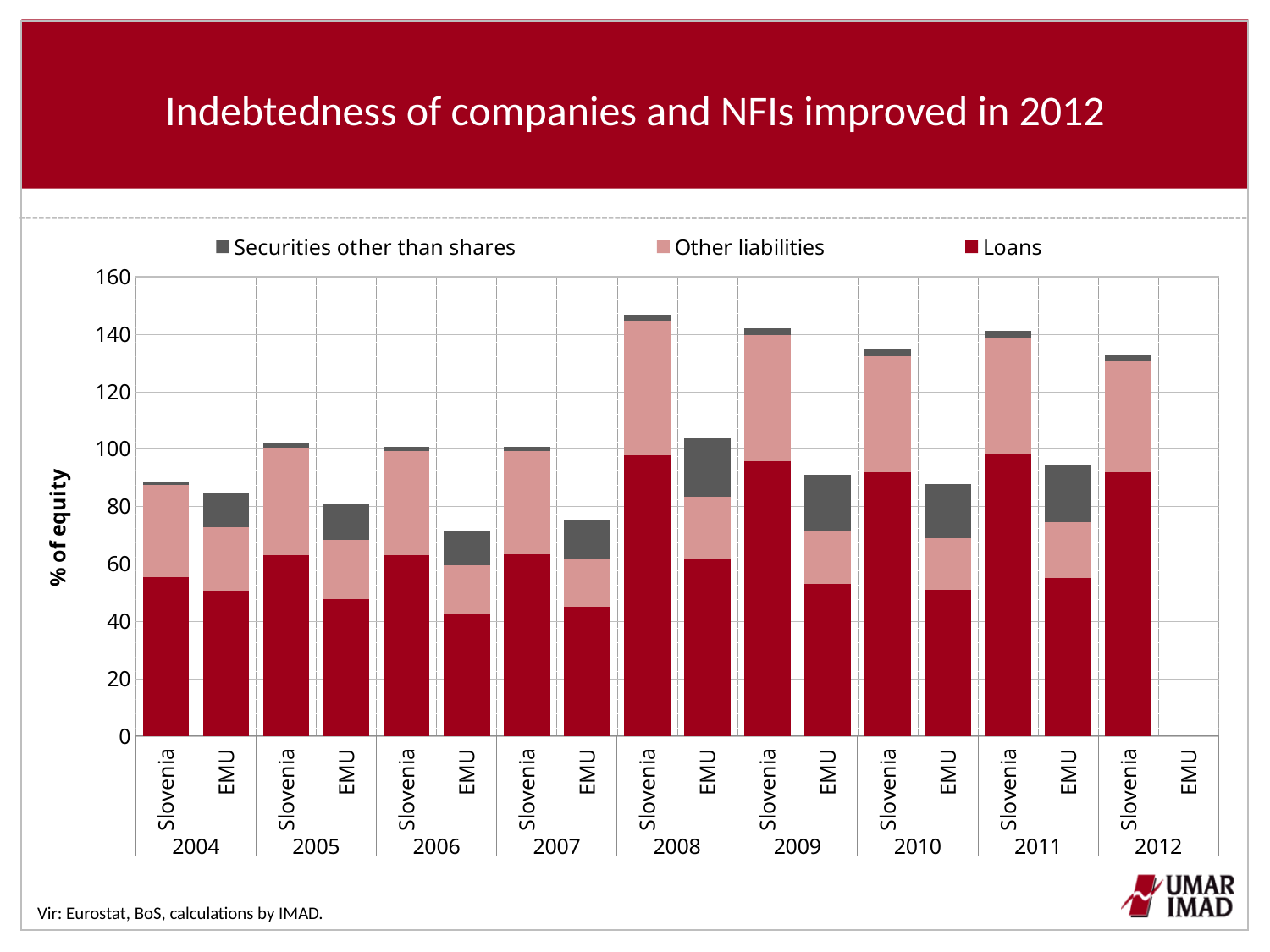
How many series does the legend list? 3 Is the total value for Slovenia in 2008 greater or less than 140? greater How many years are shown along the x axis? 9 In which year is the total bar for Slovenia the highest? 2008 Which has the larger total in 2008, Slovenia or EMU? Slovenia What is the label on the vertical axis? % of equity Is the total value for EMU in 2006 greater or less than 80? less Does the total for EMU rise or fall from 2004 to 2006? fall Is the Loans value for Slovenia in 2009 greater or less than 80? greater Is the total for Slovenia in 2012 higher or lower than in 2008? lower Which series are listed in the legend? Securities other than shares, Other liabilities, Loans What kind of chart is shown on the slide? Stacked bar chart